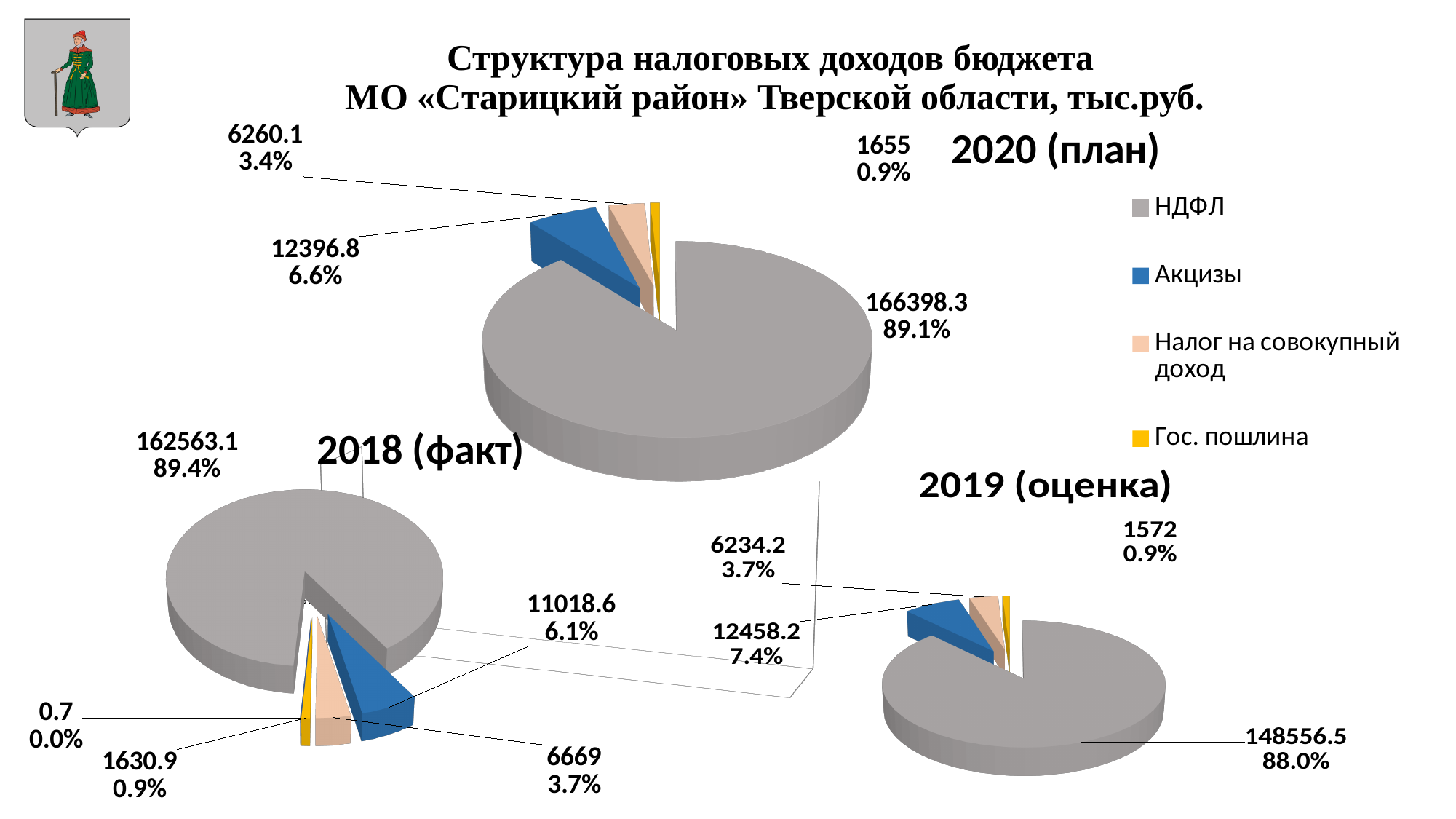
In the 2020 (план) pie chart, what is the value for НДФЛ? 166398.3 What kind of chart is used for 2018 (факт)? Pie chart In the 2020 (план) pie chart, what share of the pie does Акцизы have? 6.6% In the 2018 (факт) pie chart, what share of the pie does Гос. пошлина have? 0.9% In the 2019 (оценка) pie chart, which category has the smallest slice? Гос. пошлина In the 2019 (оценка) pie chart, what share of the pie does НДФЛ have? 88.0% In the 2020 (план) pie chart, what is the difference between the values for Акцизы and Налог на совокупный доход? 6136.7 In the 2018 (факт) pie chart, what is the value for Налог на совокупный доход? 6669 How many entries does the legend list? 4 In the 2019 (оценка) pie chart, what is the value for Акцизы? 12458.2 In the 2020 (план) pie chart, which category has the largest slice? НДФЛ Which is larger: the value for Акцизы in the 2019 (оценка) chart or in the 2018 (факт) chart? 2019 (оценка)